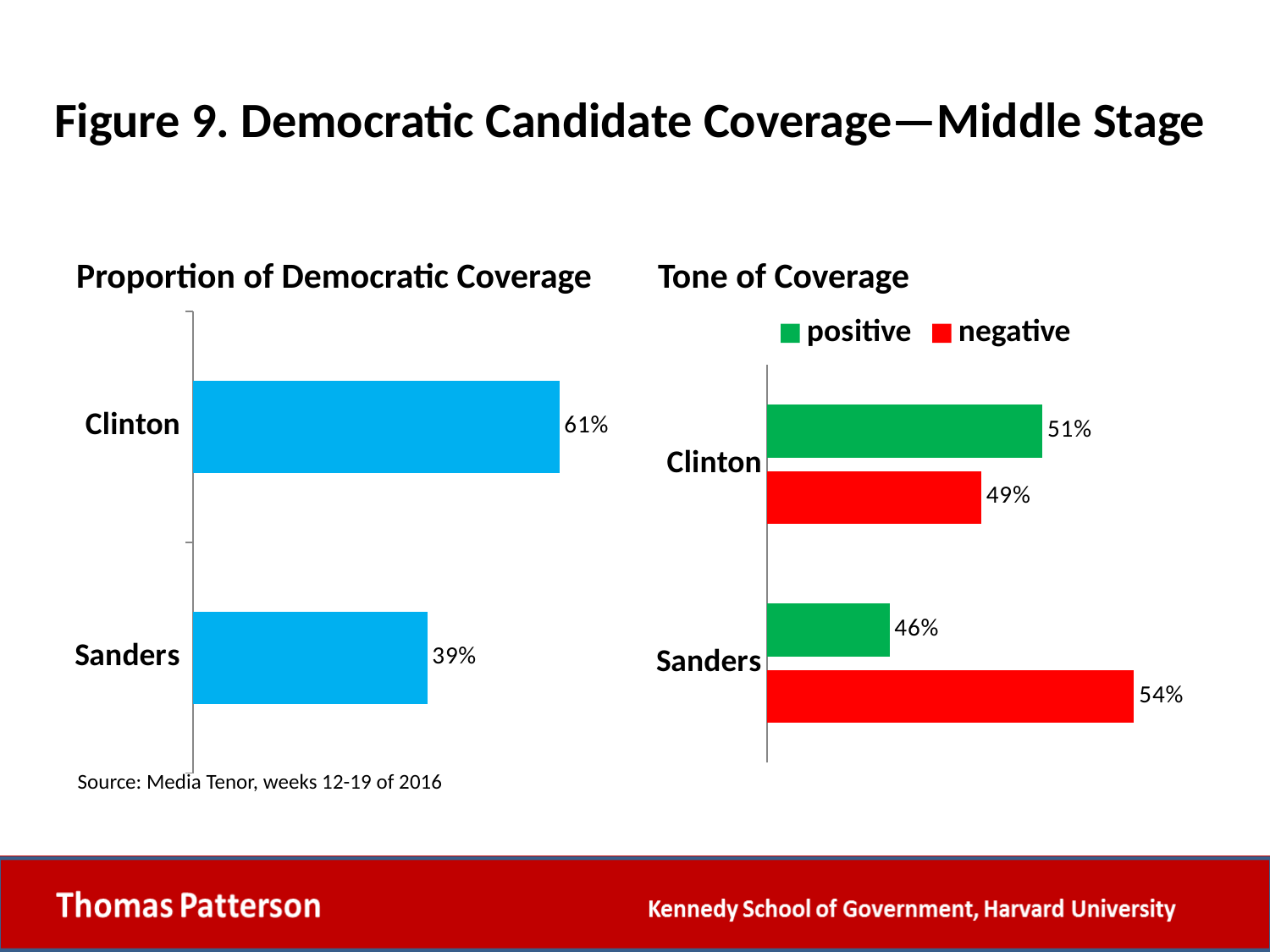
What kind of chart is the 'Proportion of Democratic Coverage' chart? bar chart In the 'Tone of Coverage' chart, what is the negative value for Sanders? 54% In the 'Proportion of Democratic Coverage' chart, what is the value for Clinton? 61% In the 'Proportion of Democratic Coverage' chart, what is the value for Sanders? 39% In the 'Proportion of Democratic Coverage' chart, which candidate has the higher proportion of coverage? Clinton In the 'Tone of Coverage' chart, which is larger for Clinton: positive or negative coverage? positive In the 'Proportion of Democratic Coverage' chart, what is the difference between Clinton's and Sanders' values? 22% In the 'Tone of Coverage' chart, what is the negative value for Clinton? 49% In the 'Tone of Coverage' chart, what is the positive value for Sanders? 46% In the 'Tone of Coverage' chart, what is the positive value for Clinton? 51% In the 'Tone of Coverage' chart, how many series does the legend list? 2 In the 'Tone of Coverage' chart, what is the difference between Sanders' negative and positive values? 8%